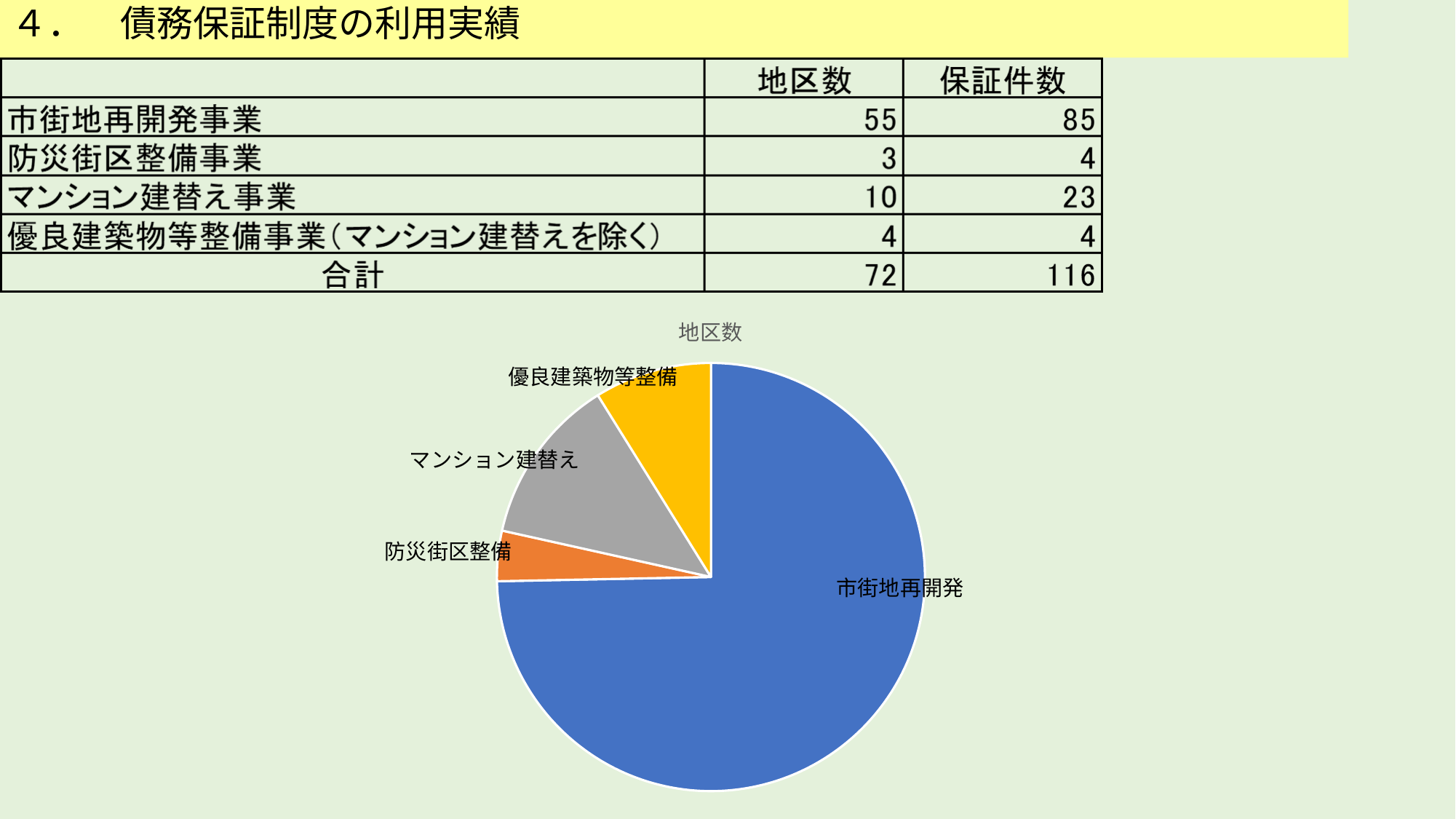
Which slice is larger in the pie chart, 防災街区整備 or 優良建築物等整備? 優良建築物等整備 Which category has the smallest slice in the pie chart? 防災街区整備 According to the table, what is the 地区数 value for 市街地再開発事業, the largest slice of the pie chart? 55 According to the table, what is the 地区数 value for マンション建替え事業? 10 Which slice is larger in the pie chart, マンション建替え or 優良建築物等整備? マンション建替え What kind of chart is shown on the slide? pie chart Which category has the largest slice in the pie chart? 市街地再開発 What is the difference in 地区数 between 市街地再開発事業 and マンション建替え事業 according to the table? 45 According to the table, what is the total 地区数 represented by the pie chart? 72 What is the title of the pie chart? 地区数 How many slices does the pie chart have? 4 What colour is the 市街地再開発 slice in the pie chart? blue